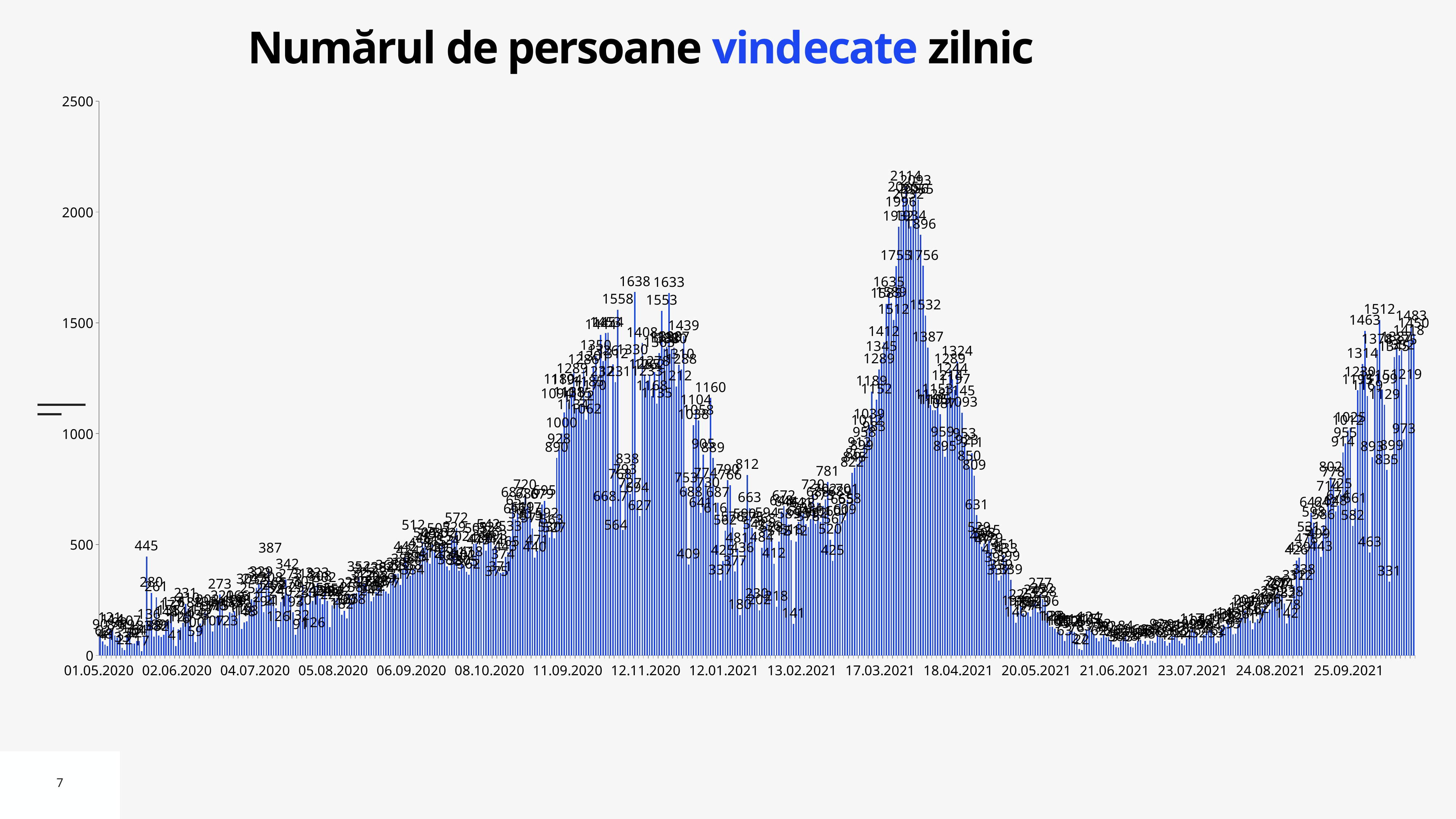
Between 18.04.2021 and 20.05.2021, do the values rise or fall? fall Is the tallest bar on the chart greater or less than 2000? greater What is the highest data label shown on the chart? 2114 What is the highest tick value shown on the vertical axis? 2500 What is the value labeled on the tall isolated bar just before 02.06.2020? 445 Are the bars around 23.07.2021 greater or less than 500? less What is the title of the chart? Numărul de persoane vindecate zilnic What is the difference between the highest label of the March 2021 peak (2114) and the highest label of the November 2020 peak (1638)? 476 Which peak is higher: the one around 17.03.2021 or the one around 12.11.2020? the peak around 17.03.2021 What kind of chart is shown on the slide? bar chart Between 24.08.2021 and 25.09.2021, do the values rise or fall? rise What is the value labeled on the tall isolated bar just after 04.07.2020? 387